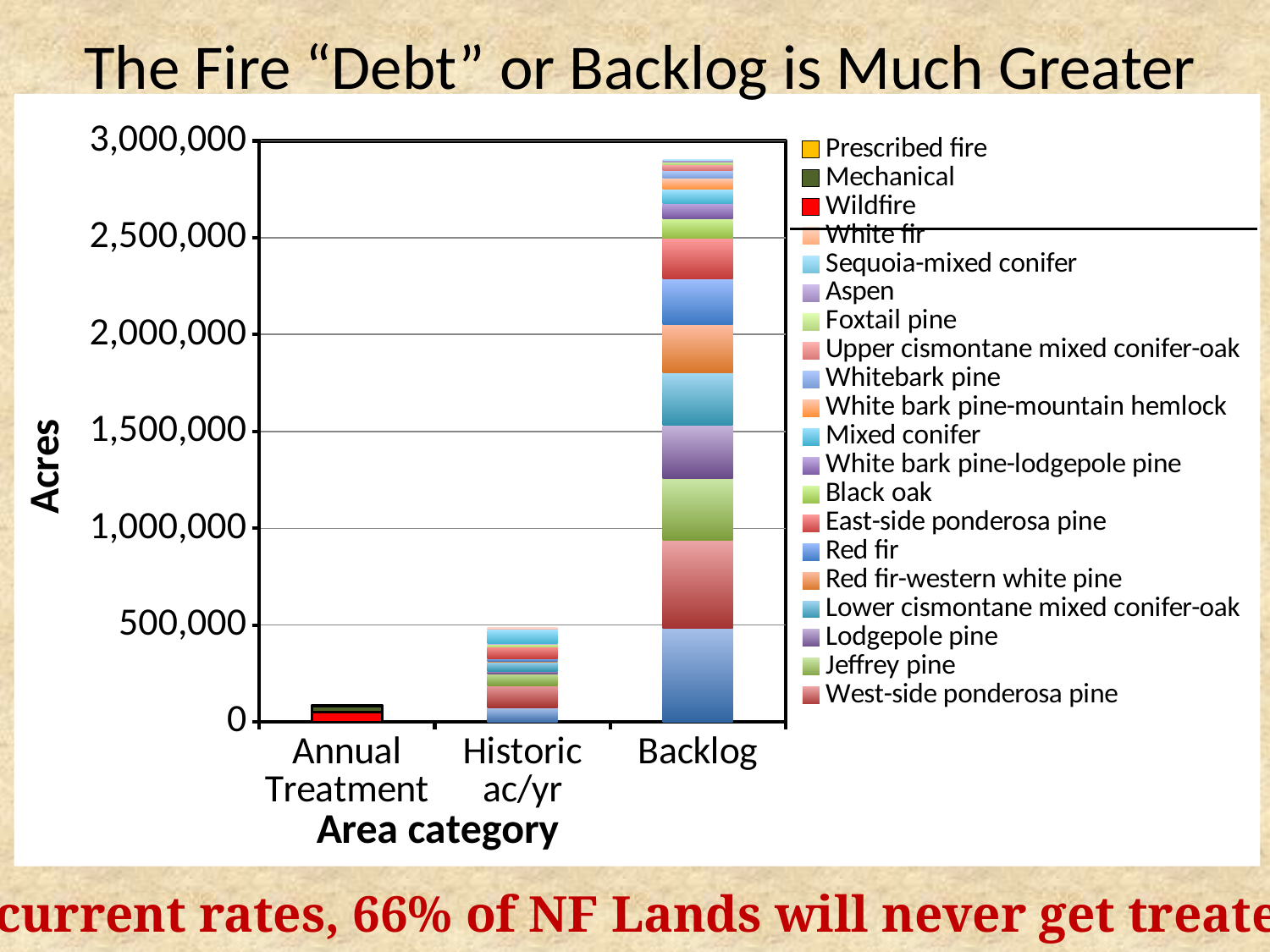
What kind of chart is shown on the slide? stacked bar chart Is the total value for Backlog greater or less than 2,500,000? greater Do the stacked bar totals rise or fall from left to right along the x axis? rise Is the total value for Annual Treatment greater or less than 500,000? less How many series does the chart's legend list? 20 Which stacked bar is taller, Annual Treatment or Historic ac/yr? Historic ac/yr Which stacked bar is taller, Historic ac/yr or Backlog? Backlog How many categories are shown on the x axis of the chart? 3 Which area category has the tallest stacked bar? Backlog Which area category has the shortest stacked bar? Annual Treatment Is the total value for Historic ac/yr greater or less than 1,000,000? less What is the title of the chart's y axis? Acres